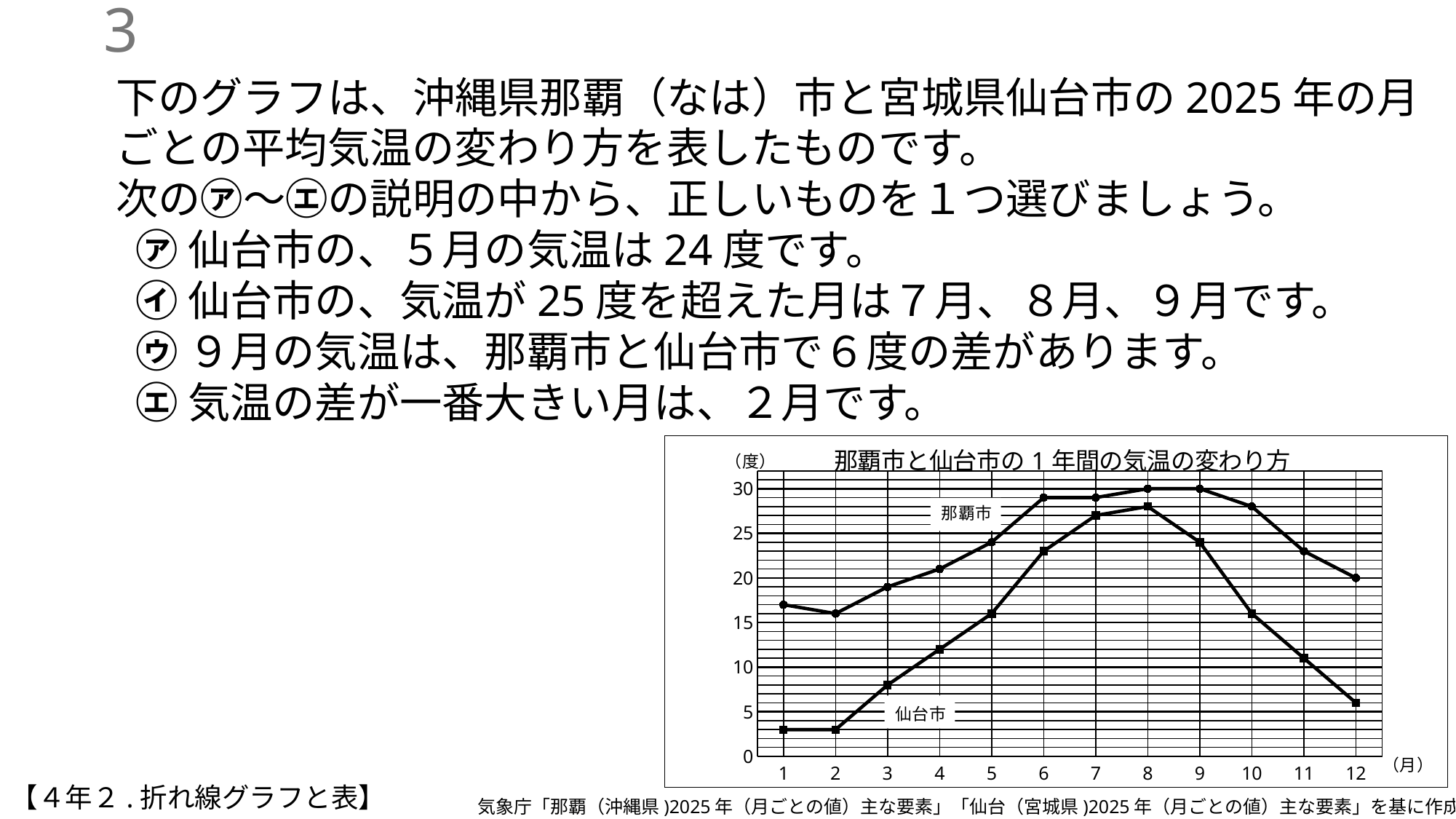
Is the value for 仙台市 in month 7 greater or less than 25? greater Do the values for 仙台市 rise or fall from month 9 to month 12? fall Is the value for 那覇市 in month 6 greater or less than 25? greater What is the title of the chart? 那覇市と仙台市の1年間の気温の変わり方 What is the temperature for 那覇市 in month 9? 30 In month 2, which city has the higher temperature, 那覇市 or 仙台市? 那覇市 Is the value for 仙台市 in month 3 greater or less than 10? less What unit is shown on the y axis of the chart? 度 What kind of chart is shown on the slide? line chart How many months are plotted along the x axis of the chart? 12 How many series does the chart show? 2 What is the temperature for 那覇市 in month 12? 20